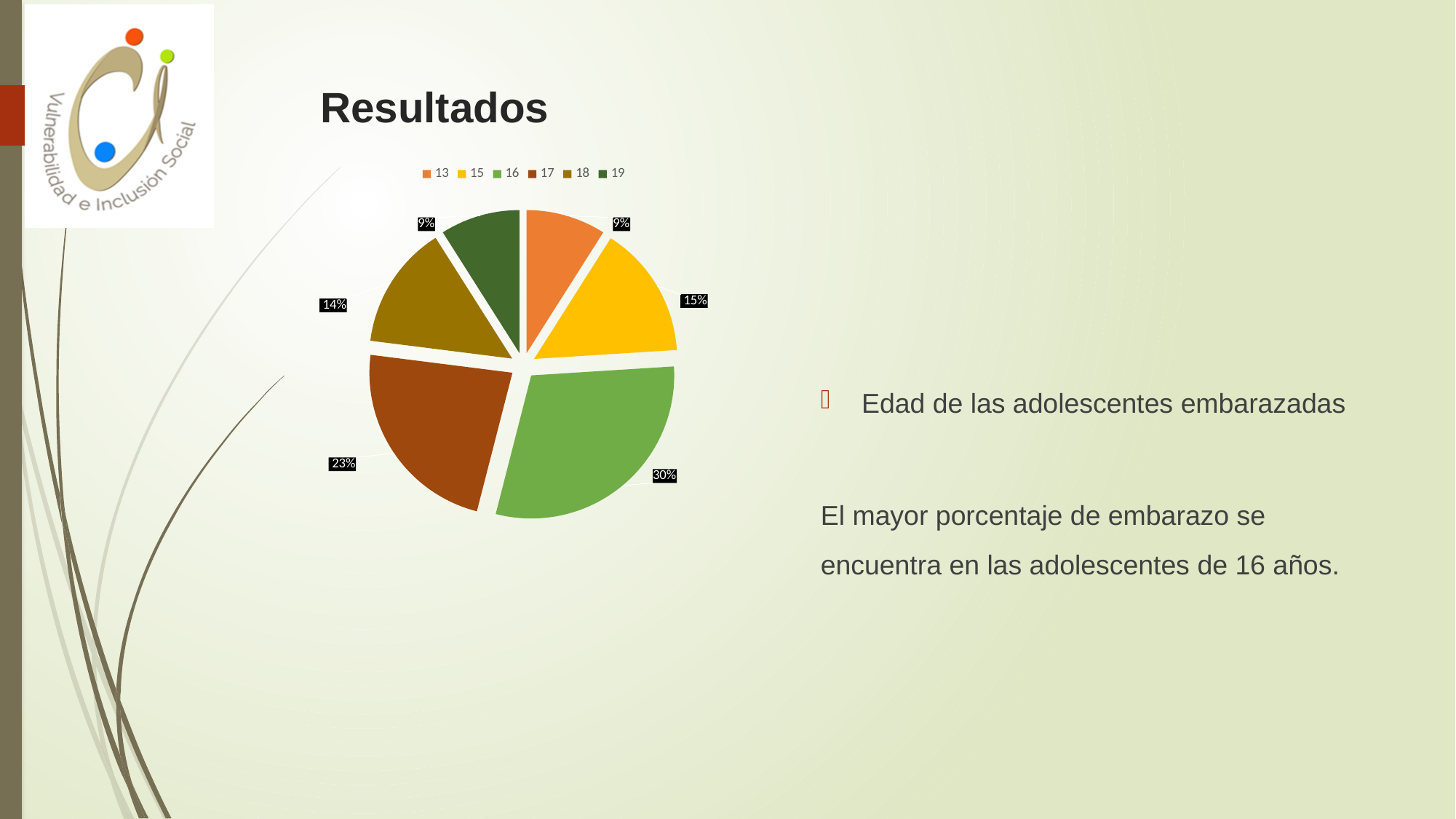
Which age has the largest slice in the pie chart? 16 What kind of chart is shown on the slide? pie chart What percentage of the pie chart corresponds to age 13? 9% What percentage of the pie chart corresponds to age 18? 14% How many entries does the legend of the pie chart list? 6 How many slices does the pie chart have? 6 Which ages are listed in the legend of the pie chart? 13, 15, 16, 17, 18, 19 What percentage of the pie chart corresponds to age 15? 15% Which slice is larger in the pie chart, age 17 or age 18? 17 What is the difference in percentage points between the slices for age 16 and age 17? 7